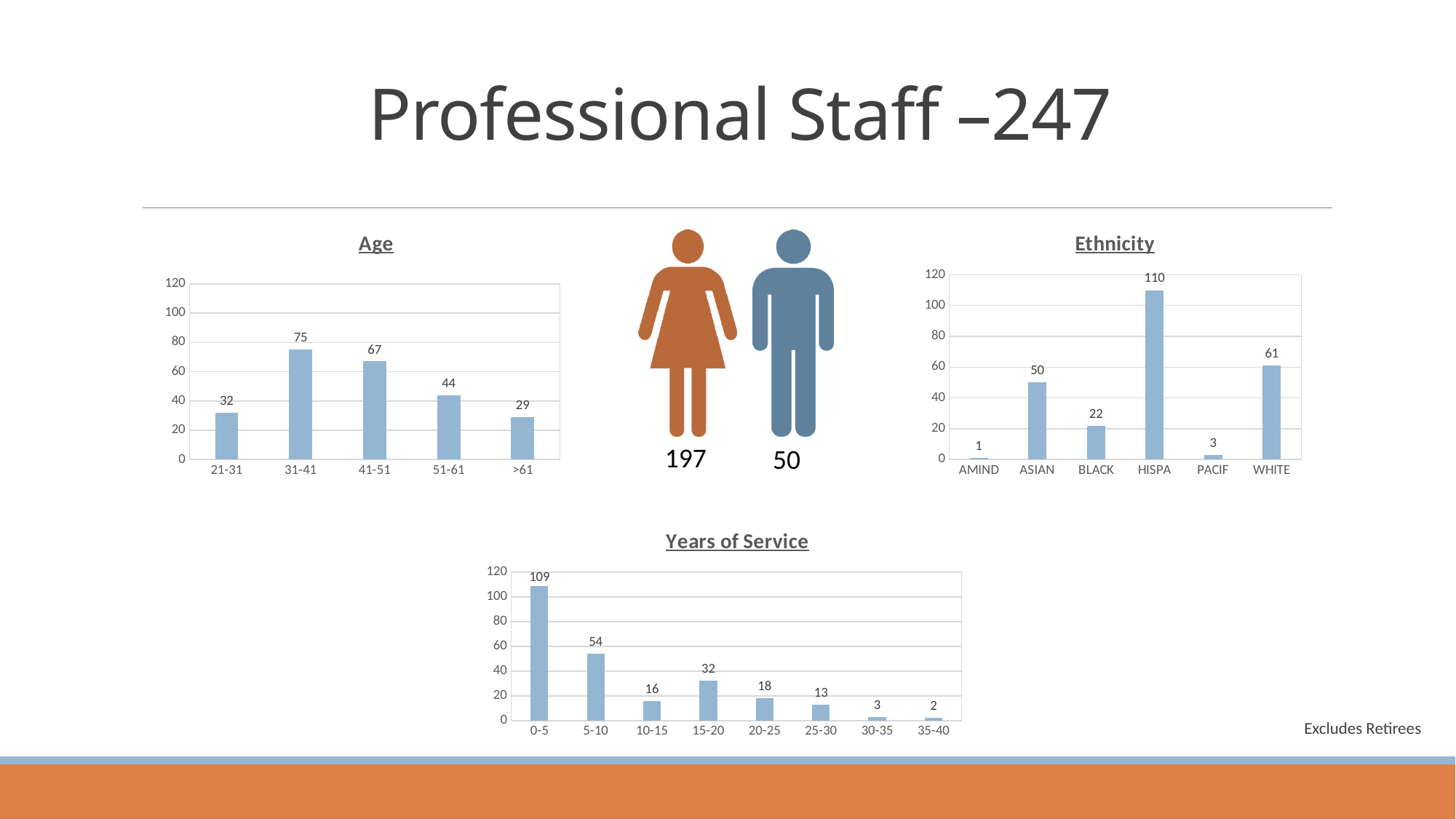
What kind of chart is the Years of Service chart? bar chart In the Age chart, which age category has the lowest value? >61 In the Ethnicity chart, which is larger, ASIAN or BLACK? ASIAN In the Years of Service chart, what is the difference between the 0-5 and 5-10 values? 55 In the Years of Service chart, what is the value for 5-10? 54 How many categories does the Years of Service chart show? 8 In the Age chart, what is the value for the 31-41 category? 75 In the Years of Service chart, which category has the highest value? 0-5 In the Ethnicity chart, what is the value for WHITE? 61 In the Ethnicity chart, which category has the highest value? HISPA How many categories does the Ethnicity chart show? 6 In the Age chart, what is the difference between the 41-51 and 51-61 values? 23